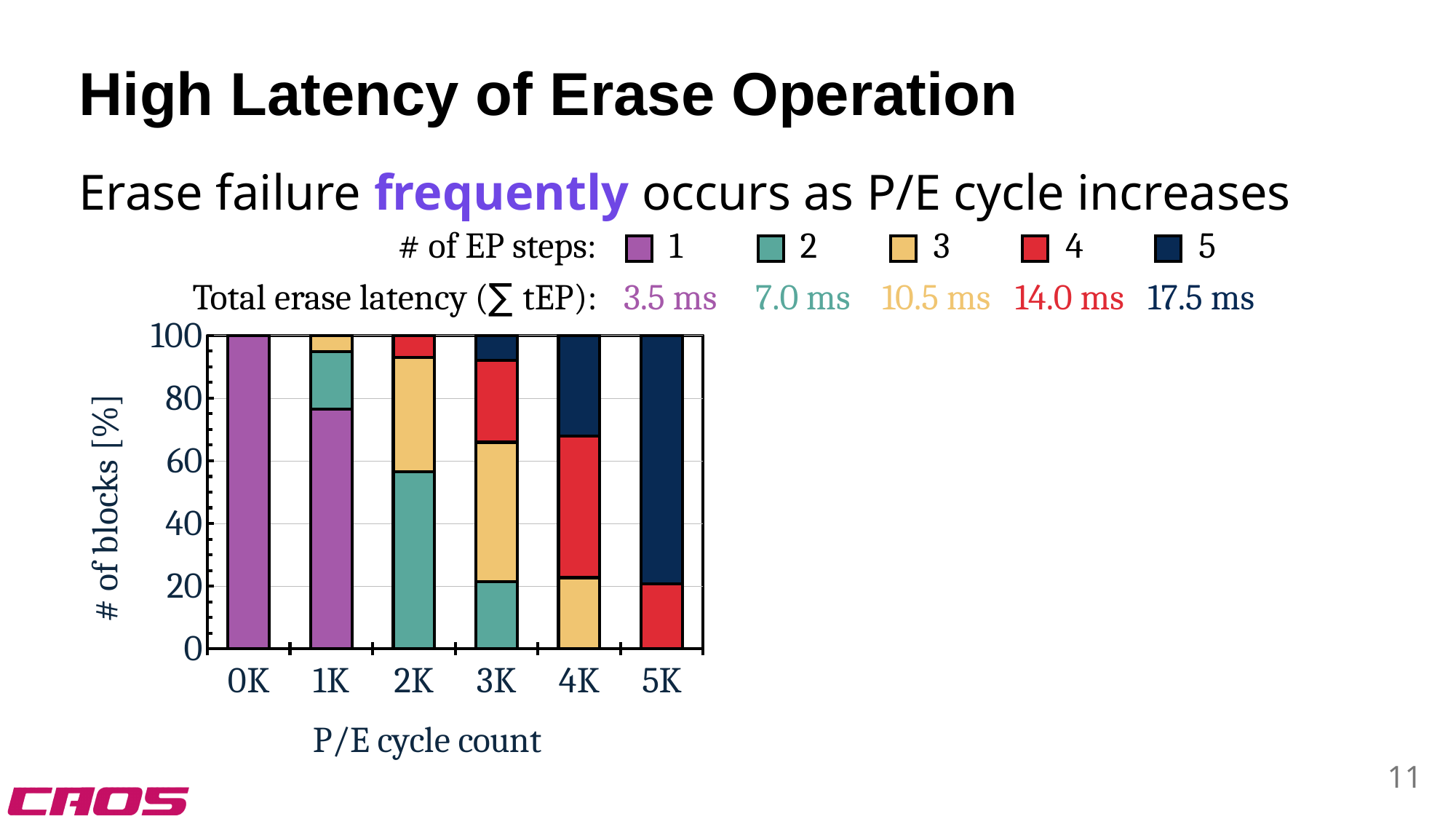
Which P/E cycle count has the largest share of blocks requiring 5 EP steps? 5K How many P/E cycle count categories are shown on the x axis? 6 Is the share of blocks needing 2 EP steps at 2K P/E cycles greater or less than 40? greater Is the share of blocks needing 1 EP step at 1K P/E cycles greater or less than 60? greater At 4K P/E cycles, which segment is larger: 3 EP steps or 4 EP steps? 4 EP steps How many series (# of EP steps) does the legend list? 5 What is the total height of the stacked bar at 3K P/E cycles? 100 What total erase latency is listed for 5 EP steps? 17.5 ms What percentage of blocks at 0K P/E cycles required 1 EP step? 100 As the P/E cycle count increases along the x axis, does the share of blocks needing only 1 EP step rise or fall? fall What kind of chart is shown on the slide? stacked bar chart Is the share of blocks needing 5 EP steps at 5K P/E cycles greater or less than 60? greater